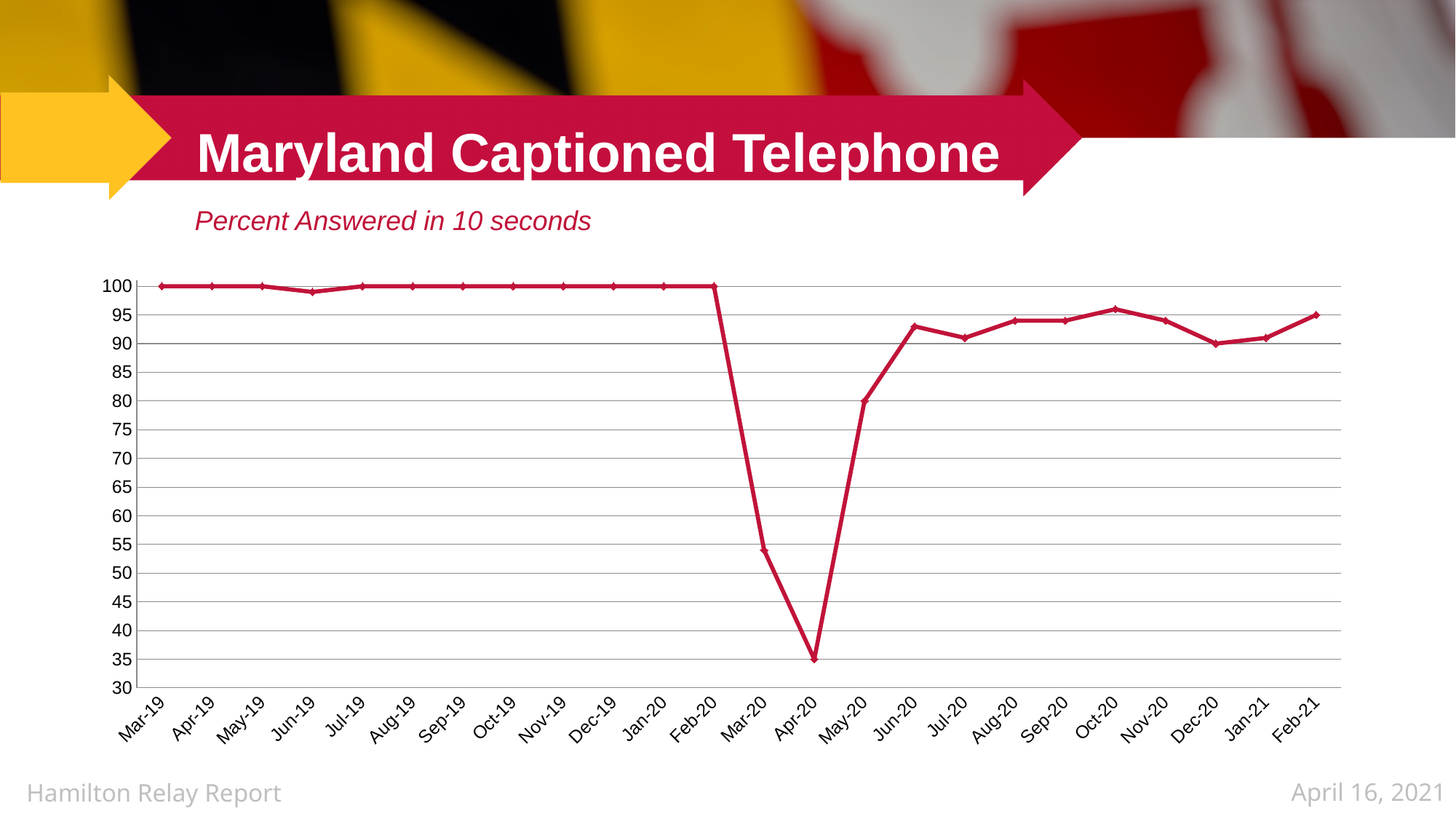
What kind of chart is shown on the slide? Line chart What is the difference between the values for May-20 and Apr-20? 45 What is the value for May-20? 80 What is the value for Apr-20? 35 What does the subtitle say the chart measures? Percent Answered in 10 seconds How many months are plotted on the x axis? 24 What is the value for Mar-19? 100 What is the title of the chart on the slide? Maryland Captioned Telephone Which is larger, the value for Apr-20 or the value for May-20? May-20 Which month has the lowest percent answered in 10 seconds? Apr-20 Is the value for Mar-20 greater or less than 60? less Do the values rise or fall from Feb-20 to Apr-20? fall